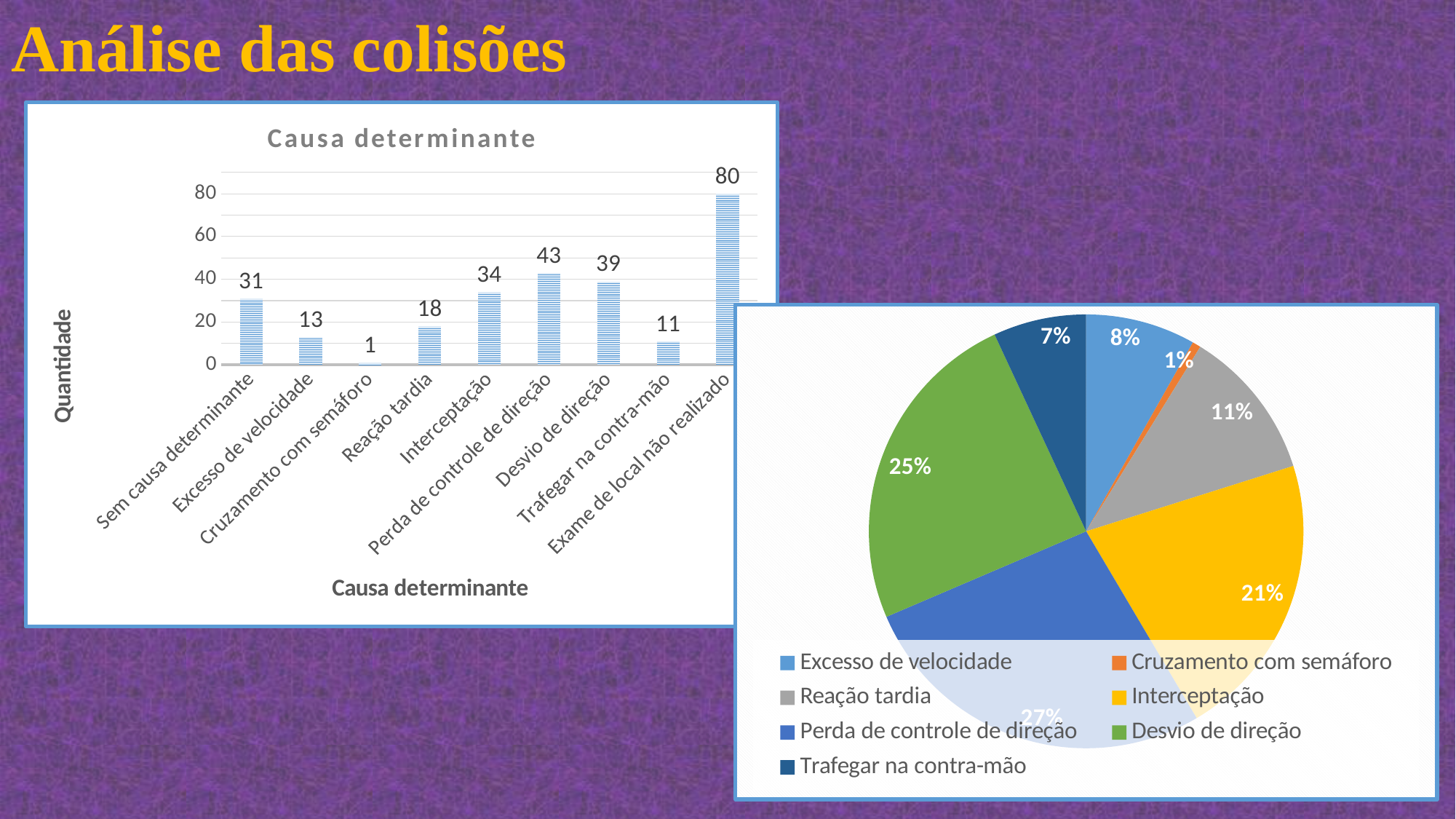
In the 'Causa determinante' bar chart, which category has the lowest value? Cruzamento com semáforo How many categories are shown in the 'Causa determinante' bar chart? 9 What type of chart is the chart titled 'Causa determinante'? Bar chart In the pie chart on the right, what share does Desvio de direção have? 25% In the 'Causa determinante' bar chart, what is the value for Exame de local não realizado? 80 How many entries does the legend of the pie chart on the right list? 7 In the pie chart on the right, what share does Cruzamento com semáforo have? 1% In the pie chart on the right, which slice is the largest? Perda de controle de direção In the 'Causa determinante' bar chart, what is the value for Perda de controle de direção? 43 In the 'Causa determinante' bar chart, which is larger: Sem causa determinante or Reação tardia? Sem causa determinante In the 'Causa determinante' bar chart, what is the difference between Desvio de direção and Interceptação? 5 In the 'Causa determinante' bar chart, which category has the highest value? Exame de local não realizado